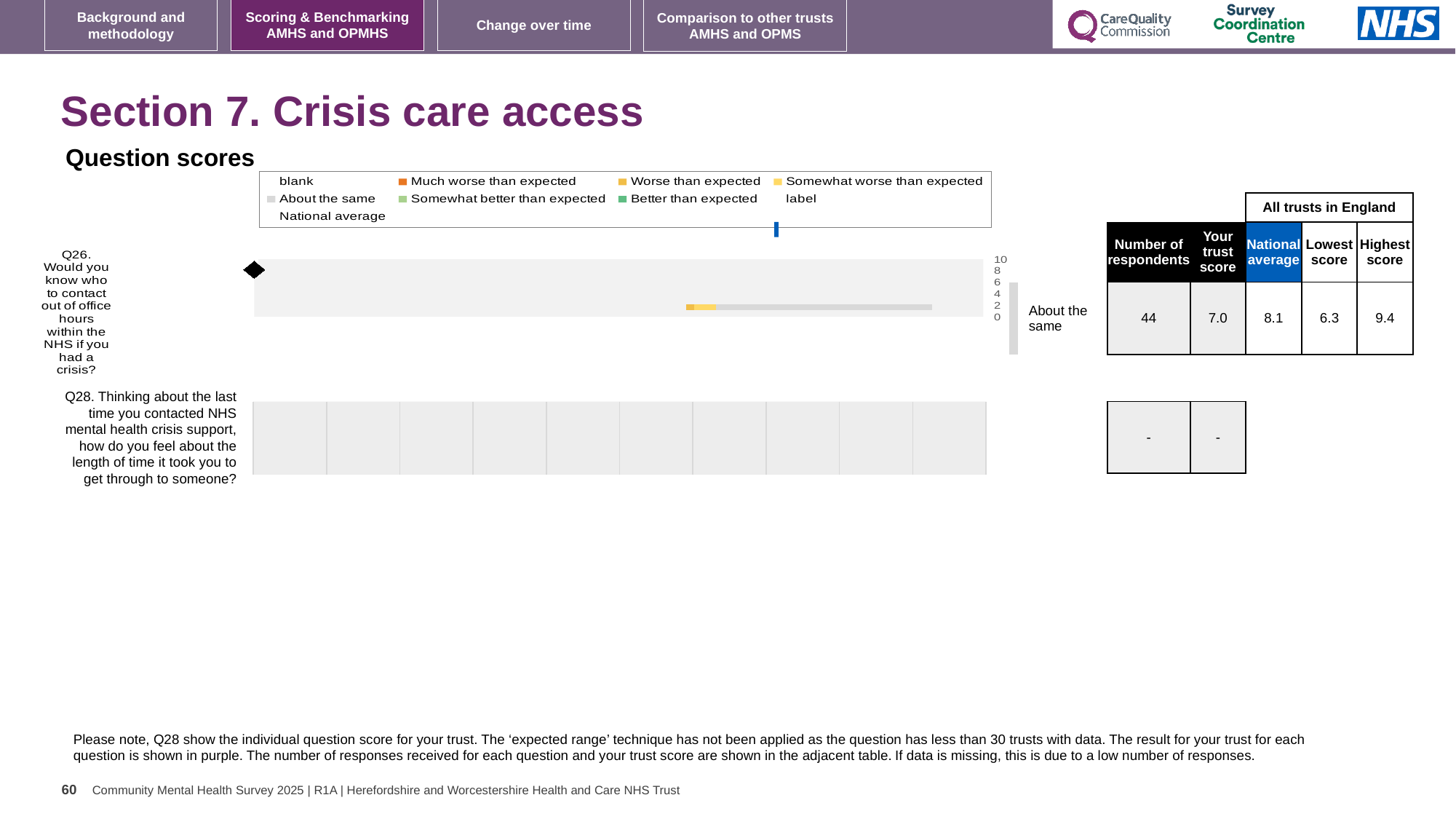
By how much does the national average exceed the trust score for Q26? 1.1 How many questions are listed in the Question scores chart? 2 What is shown as the trust score for Q28 in the table? - What is the trust score for Q26 (Would you know who to contact out of office hours within the NHS if you had a crisis?)? 7.0 What is the difference between the highest and lowest trust scores for Q26? 3.1 What is the lowest score among all trusts in England for Q26? 6.3 Which expected-range category is the trust's Q26 score placed in? About the same What is the national average score for Q26? 8.1 What kind of chart is used to show the question scores? Bar chart What is the highest score among all trusts in England for Q26? 9.4 How many respondents answered Q26? 44 For Q26, which is larger: the trust score or the national average? National average